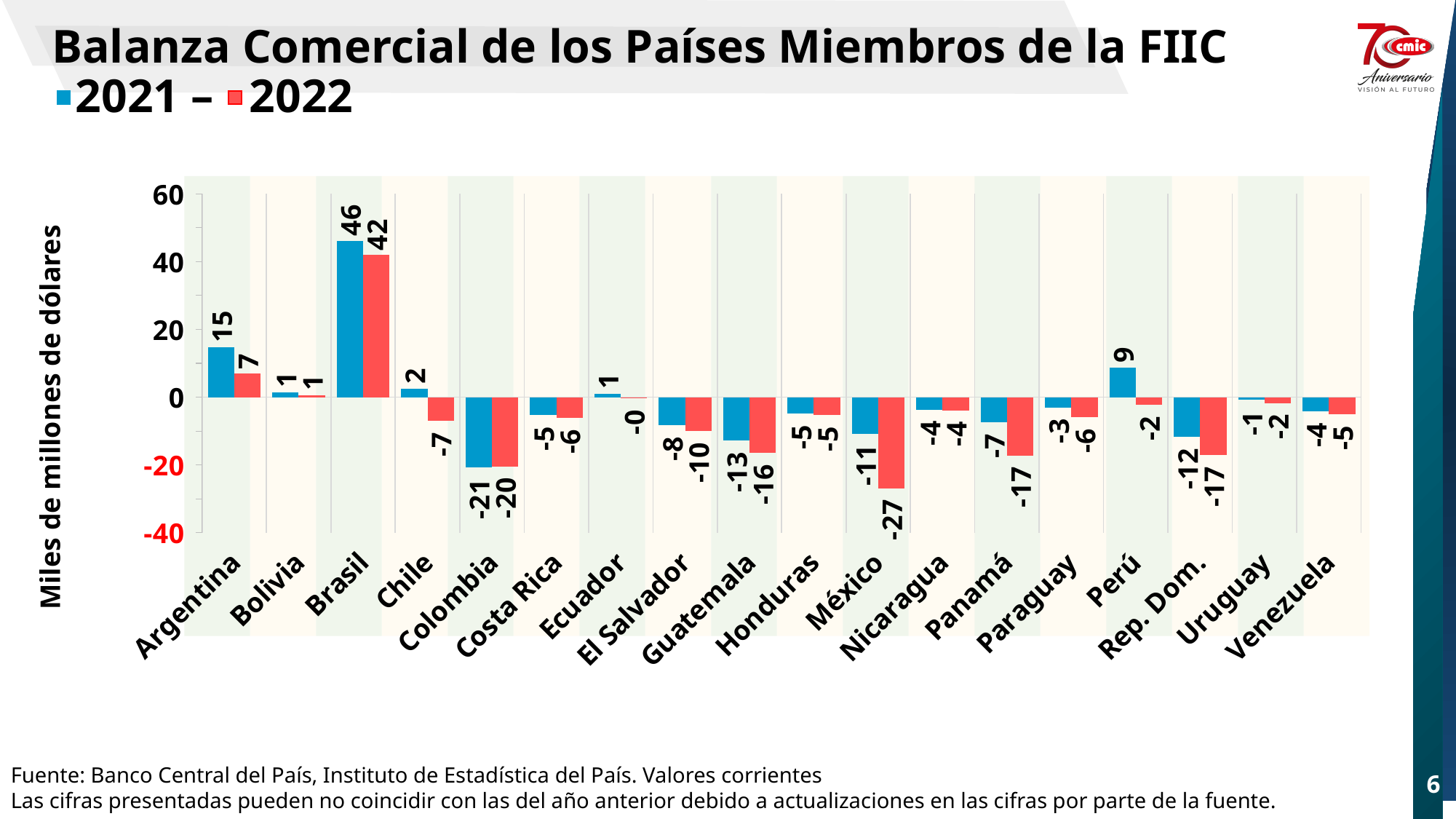
Which is larger, the 2021 value for Argentina or the 2021 value for Perú? Argentina What is the value for Panamá in 2022? -17 By how much did México's value change from 2021 to 2022? 16 How many countries are shown on the x axis? 18 What is the value for Perú in 2021? 9 What kind of chart is shown on the slide? Bar chart How many series does the legend list? 2 What is the value for México in 2022? -27 What is the difference between Brasil's 2021 and 2022 values? 4 Which country has the lowest value in 2022? México Which country has the highest value in 2022? Brasil What is the value for Brasil in 2021? 46